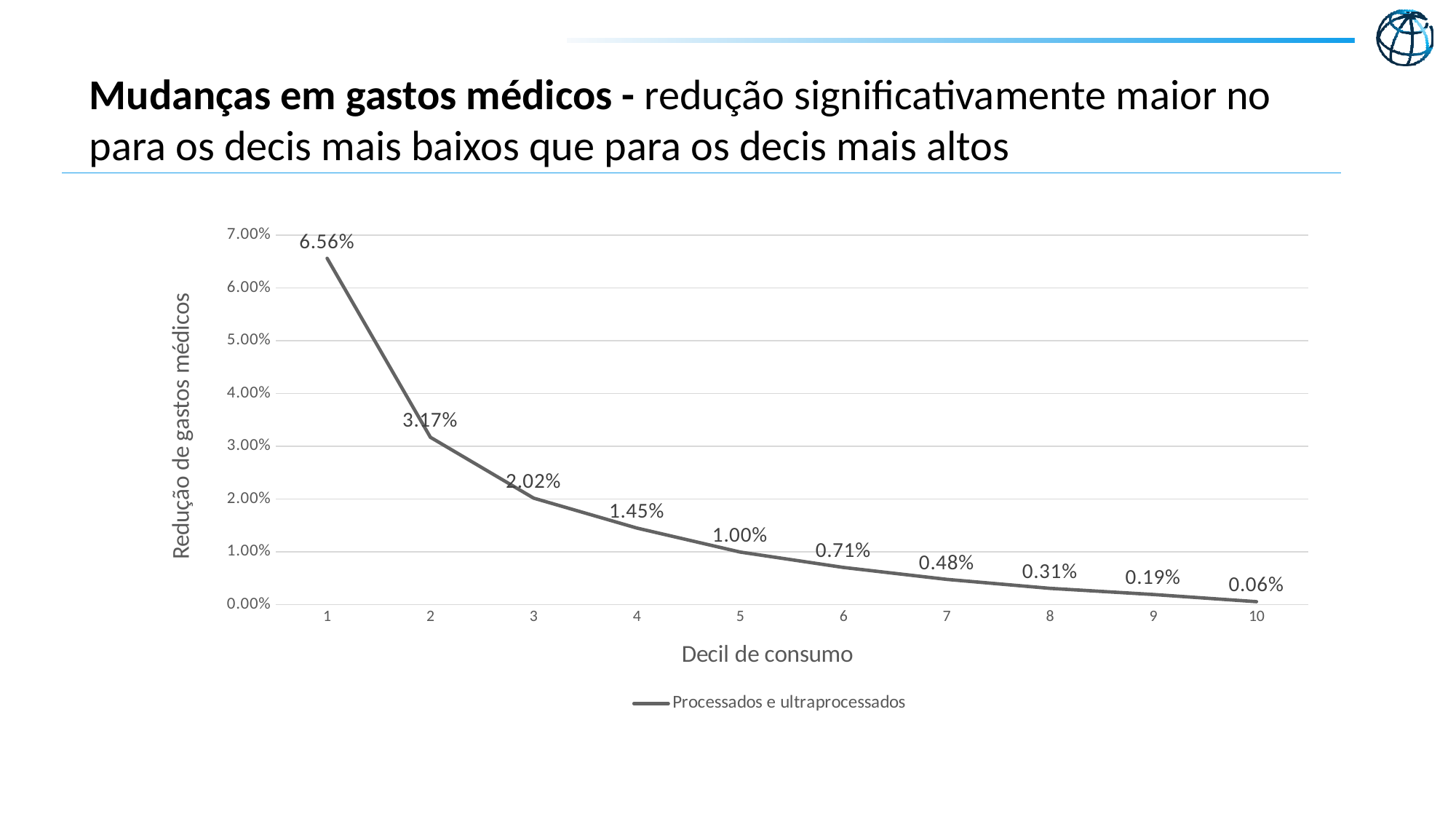
How many deciles are plotted on the x axis? 10 Which decile has the highest reduction in medical spending? 1 Which is larger, the value for decile 3 or the value for decile 4? decile 3 What kind of chart is shown? line chart What is the value for decile 5? 1.00% Is the value for decile 2 greater or less than 3.00%? greater What is the difference between the values for decile 1 and decile 2? 3.39% Do the values rise or fall as the decile increases? fall What is the value for decile 1? 6.56% How many series does the legend list? 1 What is the value for decile 10? 0.06% Which decile has the lowest reduction in medical spending? 10